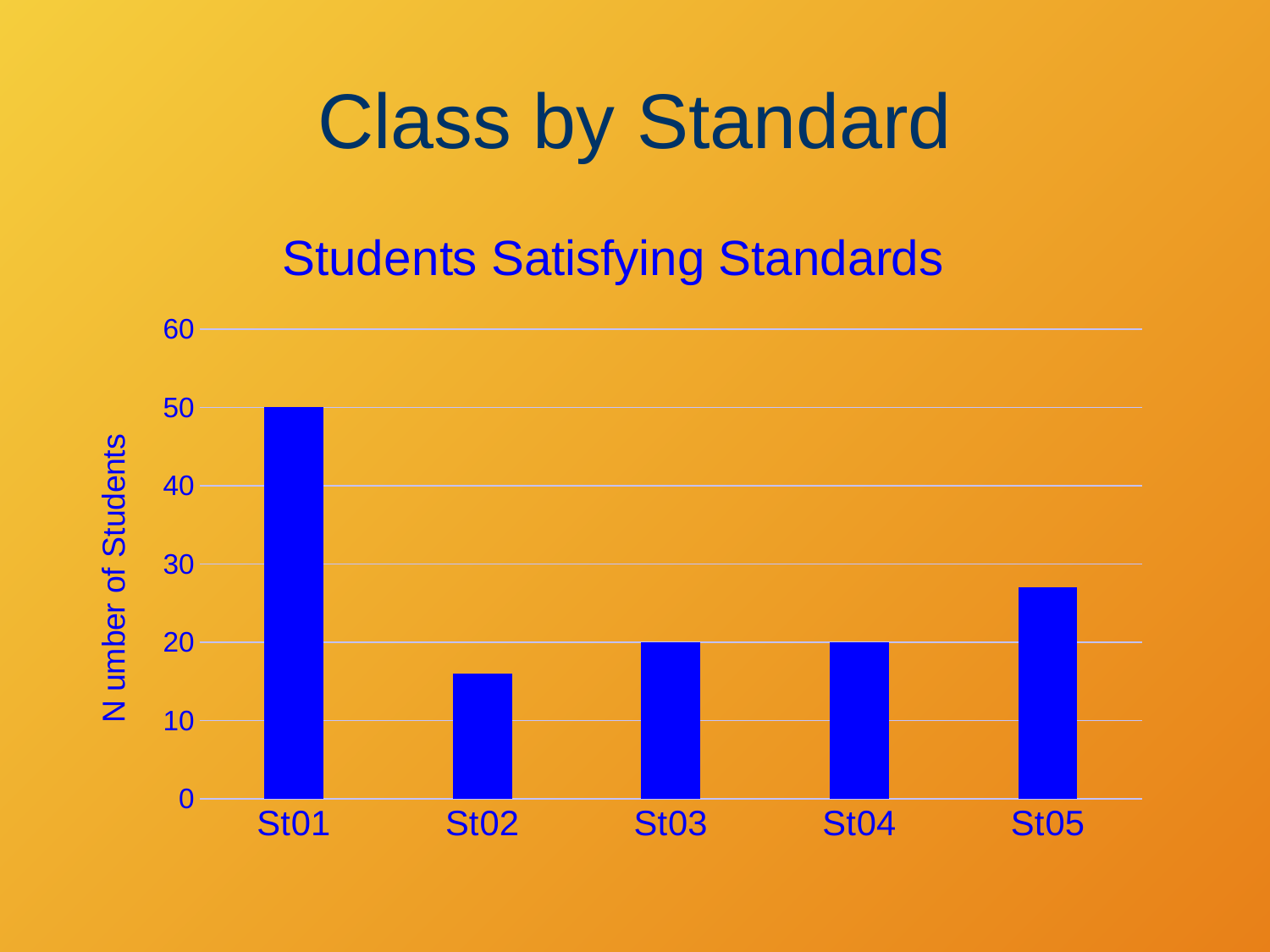
Which standard has the highest number of students? St01 What is the number of students for St03? 20 What is the number of students for St01? 50 What is the number of students for St04? 20 What is the difference between the values for St01 and St03? 30 What is the title of the chart? Students Satisfying Standards Is the value for St02 greater or less than 20? less Is the value for St05 greater or less than 30? less What kind of chart is shown on the slide? bar chart How many standards (categories) are shown on the x axis? 5 Which standard has the lowest number of students? St02 What is the label on the vertical axis of the chart? Number of Students